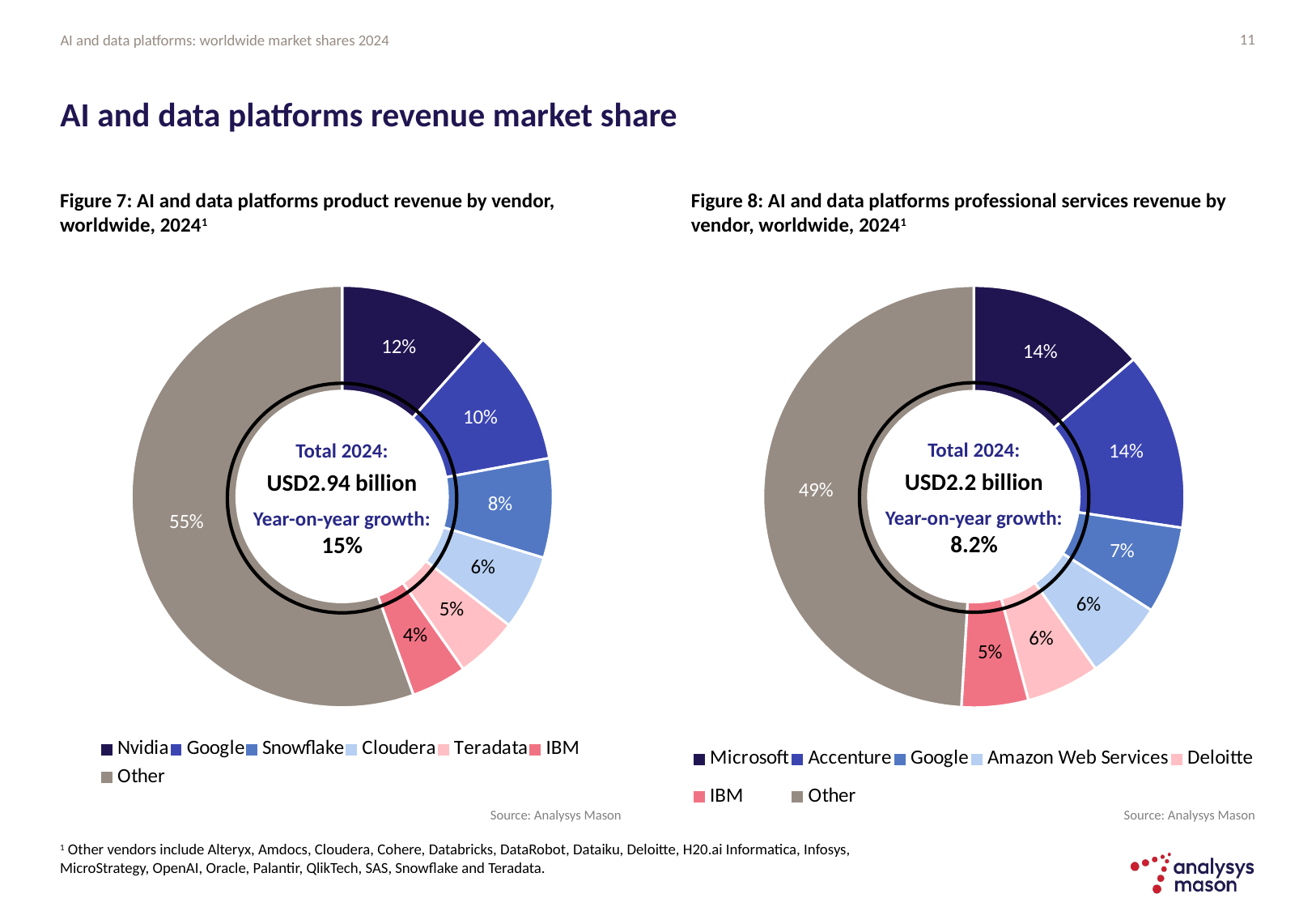
What type of chart is used in Figure 7 and Figure 8? Pie (donut) chart In Figure 8 (professional services revenue by vendor), which is larger, the share for Accenture or the share for IBM? Accenture In Figure 7 (product revenue by vendor), what is the total 2024 market value shown in the centre of the chart? USD2.94 billion In Figure 7 (product revenue by vendor), what share does Snowflake hold? 8% In Figure 7 (product revenue by vendor), how many segments does the legend list? 7 In Figure 8 (professional services revenue by vendor), what share does Other hold? 49% In Figure 7 (product revenue by vendor), what is the difference in share between Google and Cloudera? 4 percentage points In Figure 8 (professional services revenue by vendor), what share does Google hold? 7% In Figure 8 (professional services revenue by vendor), what year-on-year growth is shown in the centre of the chart? 8.2% In Figure 7 (product revenue by vendor), what share does Nvidia hold? 12% In Figure 7 (product revenue by vendor), which named vendor (excluding Other) has the smallest share? IBM In Figure 8 (professional services revenue by vendor), what is the combined share of Microsoft and Accenture? 28%